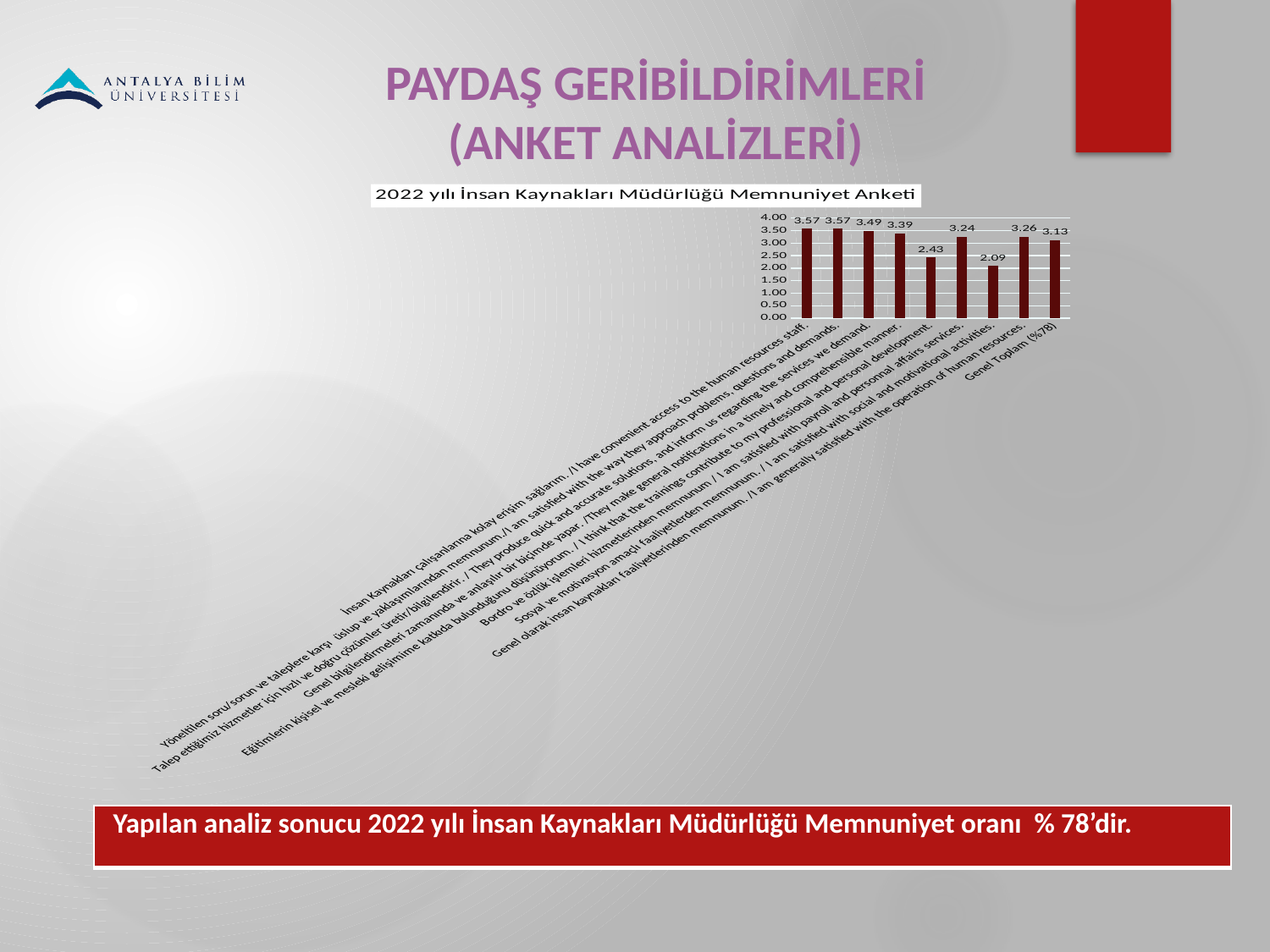
Which is larger: the value for 'Genel olarak insan kaynakları faaliyetlerinden memnunum' or the value for 'Genel Toplam (%78)'? Genel olarak insan kaynakları faaliyetlerinden memnunum What is the title of the chart? 2022 yılı İnsan Kaynakları Müdürlüğü Memnuniyet Anketi What is the value for the 'Bordro ve özlük işlemleri hizmetlerinden memnunum' category? 3.24 What is the value for the 'Sosyal ve motivasyon amaçlı faaliyetlerden memnunum' category? 2.09 What is the difference between the value for 'Bordro ve özlük işlemleri hizmetlerinden memnunum' and the value for 'Eğitimlerin kişisel ve mesleki gelişimime katkıda bulunduğunu düşünüyorum'? 0.81 What is the value for the 'Eğitimlerin kişisel ve mesleki gelişimime katkıda bulunduğunu düşünüyorum' category? 2.43 Is the value for 'Genel Toplam (%78)' greater or less than 3.00? greater What is the value for the 'Genel Toplam (%78)' category? 3.13 Which category has the lowest value? Sosyal ve motivasyon amaçlı faaliyetlerden memnunum What type of chart is shown on the slide? Bar chart How many bars (categories) does the chart show? 9 What is the highest value shown on the vertical axis? 4.00